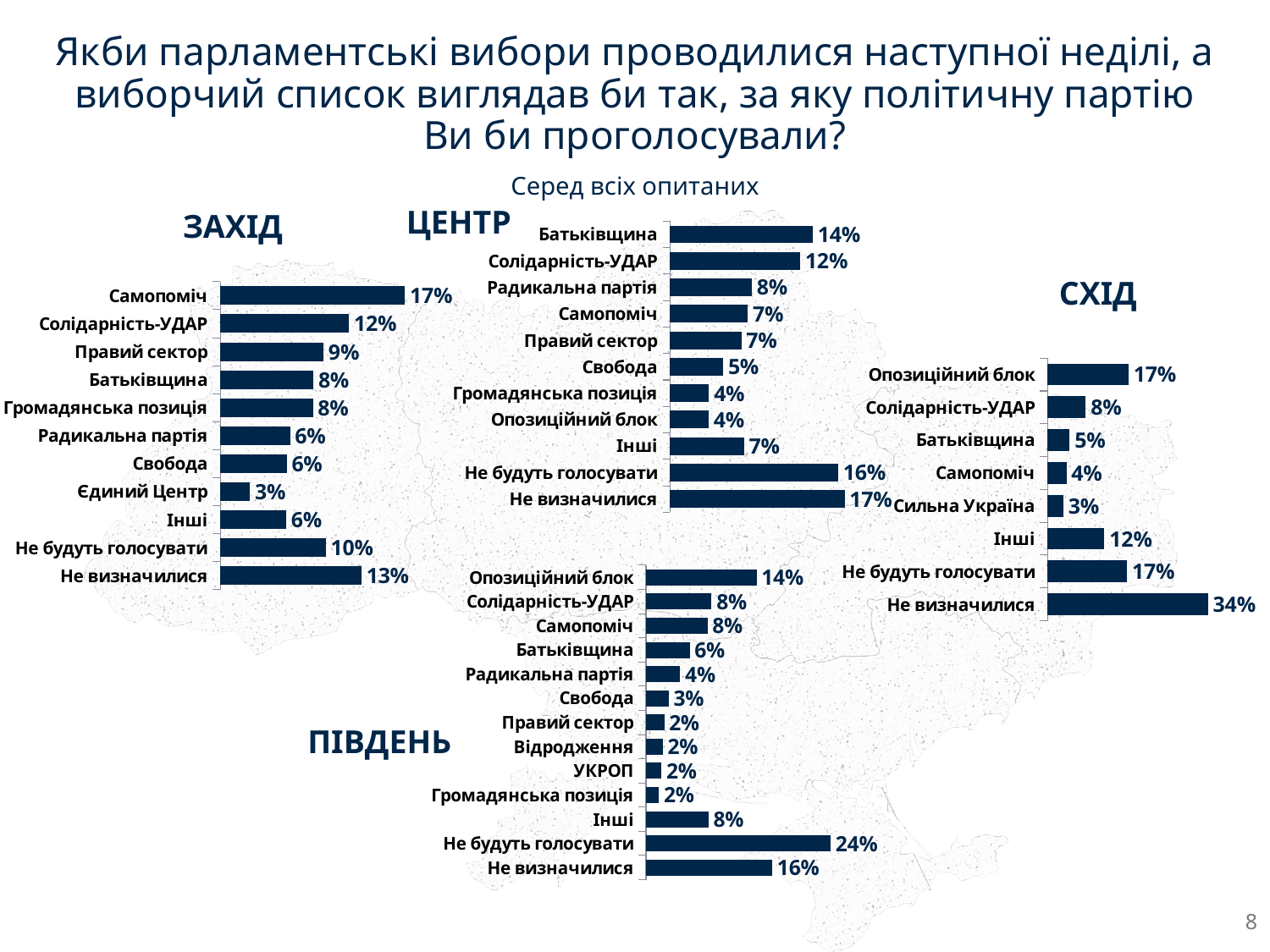
In the ПІВДЕНЬ chart, which is larger: Опозиційний блок or Самопоміч? Опозиційний блок In the СХІД chart, which category has the highest value? Не визначилися In the ЗАХІД chart, what is the value for Самопоміч? 17% What type of chart is the ЦЕНТР chart? Bar chart In the ЦЕНТР chart, what is the value for Батьківщина? 14% How many categories are shown in the ПІВДЕНЬ chart? 13 In the ПІВДЕНЬ chart, what is the value for Не будуть голосувати? 24% In the ЗАХІД chart, which category has the lowest value? Єдиний Центр In the ЦЕНТР chart, what is the difference between Не визначилися and Солідарність-УДАР? 5% In the ЗАХІД chart, what is the difference between Самопоміч and Солідарність-УДАР? 5% How many categories are shown in the СХІД chart? 8 In the СХІД chart, what is the value for Не визначилися? 34%